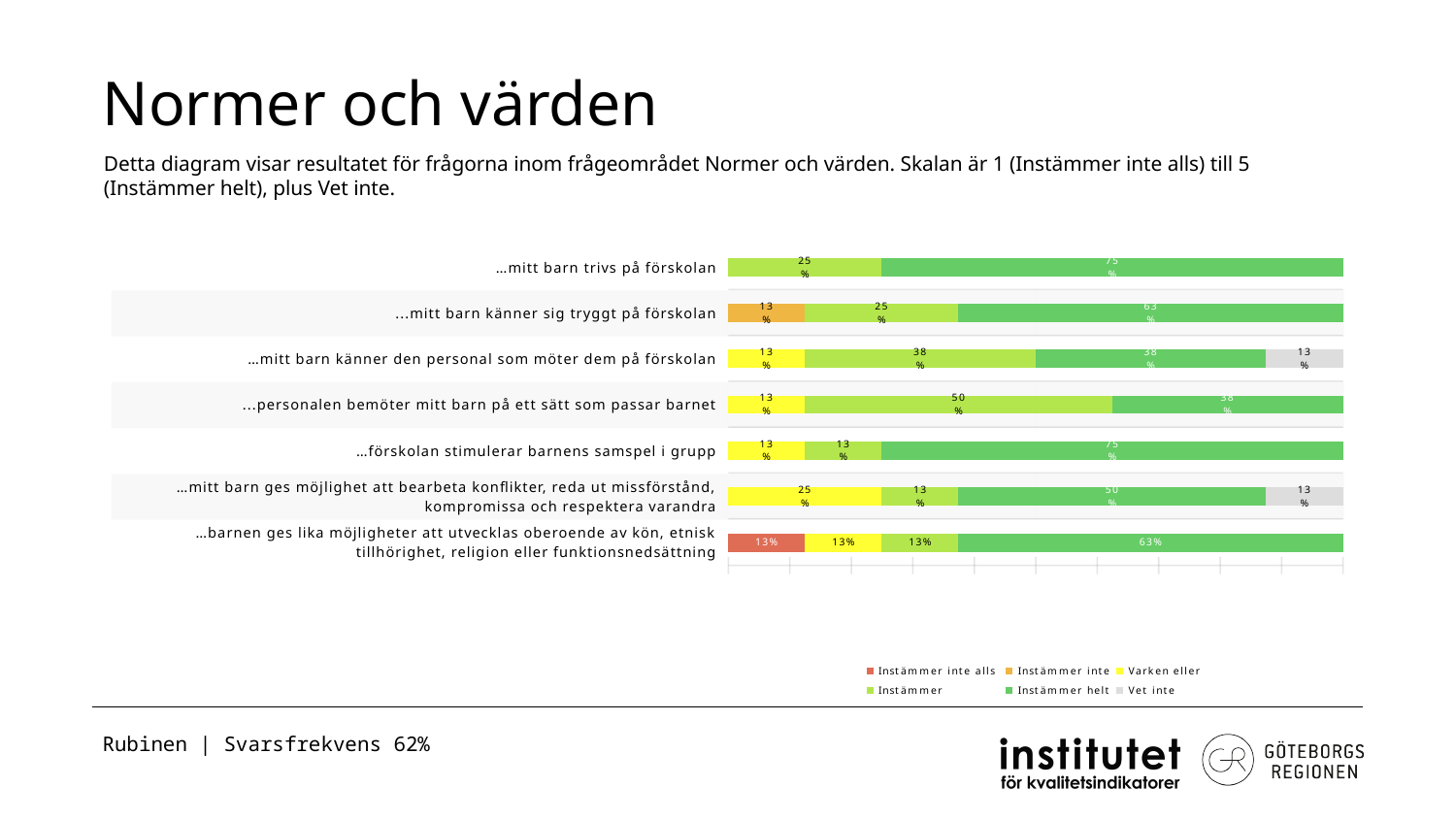
What is the 'Instämmer' value for '…personalen bemöter mitt barn på ett sätt som passar barnet'? 50% What is the response rate (Svarsfrekvens) shown at the bottom of the slide? 62% Which is larger: the 'Instämmer helt' value for '…mitt barn känner sig tryggt på förskolan' or for '…personalen bemöter mitt barn på ett sätt som passar barnet'? …mitt barn känner sig tryggt på förskolan What kind of chart is shown on the slide? stacked bar chart What is the 'Vet inte' value for '…mitt barn känner den personal som möter dem på förskolan'? 13% How many series does the legend list? 6 Which statement is the only one with an 'Instämmer inte' (orange) segment? …mitt barn känner sig tryggt på förskolan What is the 'Instämmer inte alls' value for '…barnen ges lika möjligheter att utvecklas oberoende av kön, etnisk tillhörighet, religion eller funktionsnedsättning'? 13% How many statements (categories) are plotted in the chart? 7 What is the difference between the 'Instämmer helt' value for '…mitt barn trivs på förskolan' and the 'Instämmer helt' value for '…mitt barn ges möjlighet att bearbeta konflikter, reda ut missförstånd, kompromissa och respektera varandra'? 25% What is the 'Instämmer helt' value for '…mitt barn trivs på förskolan'? 75% Which statement has the largest 'Instämmer' share? …personalen bemöter mitt barn på ett sätt som passar barnet